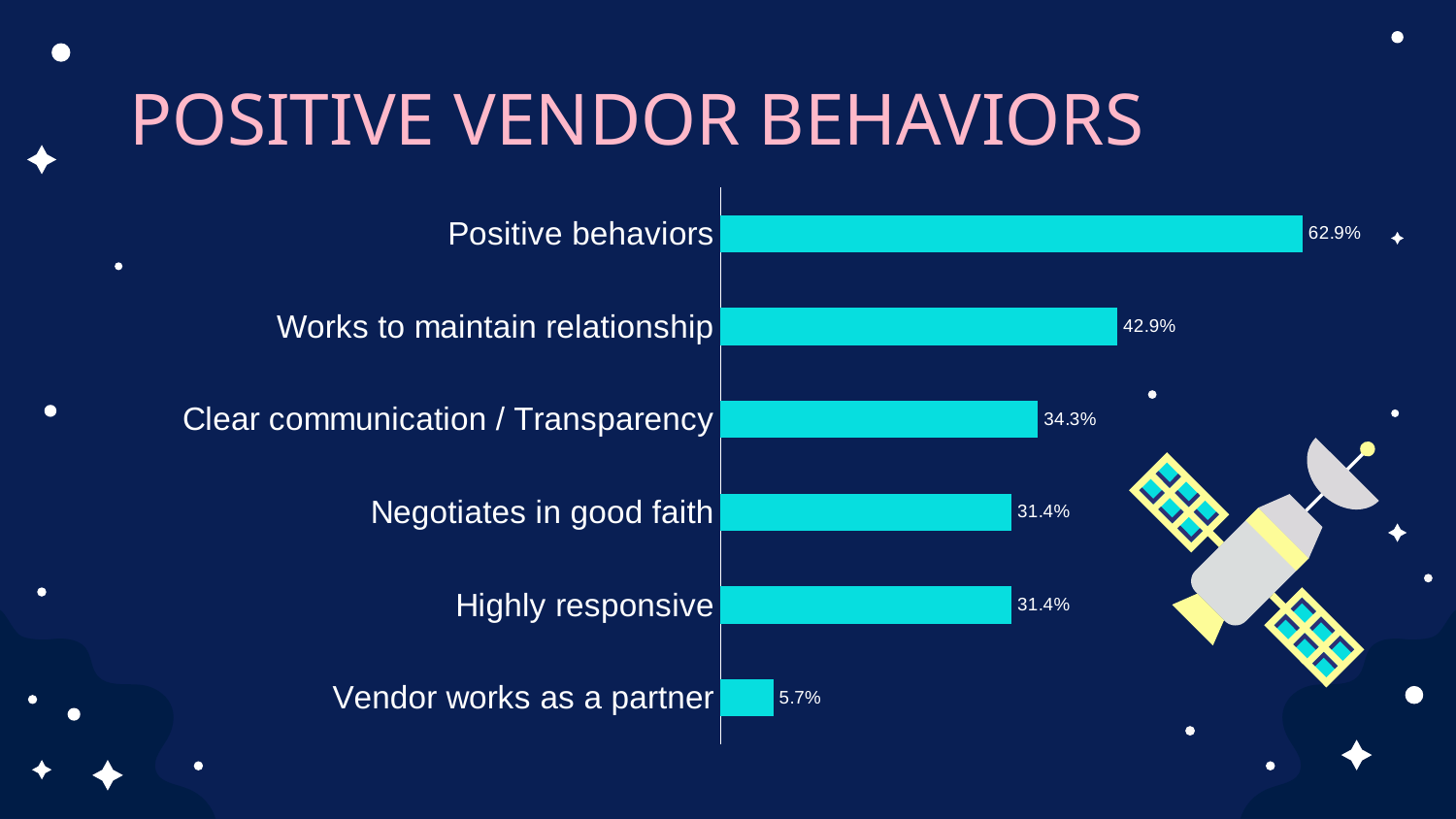
What is the title of the slide containing the chart? POSITIVE VENDOR BEHAVIORS What kind of chart is shown on the slide? Bar chart What is the value for Vendor works as a partner? 5.7% What is the value for Positive behaviors? 62.9% What is the value for Clear communication / Transparency? 34.3% Which is larger, the value for Works to maintain relationship or the value for Highly responsive? Works to maintain relationship Which category has the highest value? Positive behaviors What is the difference between the values for Positive behaviors and Works to maintain relationship? 20.0% What is the difference between the values for Clear communication / Transparency and Negotiates in good faith? 2.9% What is the value for Works to maintain relationship? 42.9% Which category has the lowest value? Vendor works as a partner How many categories are shown in the chart? 6